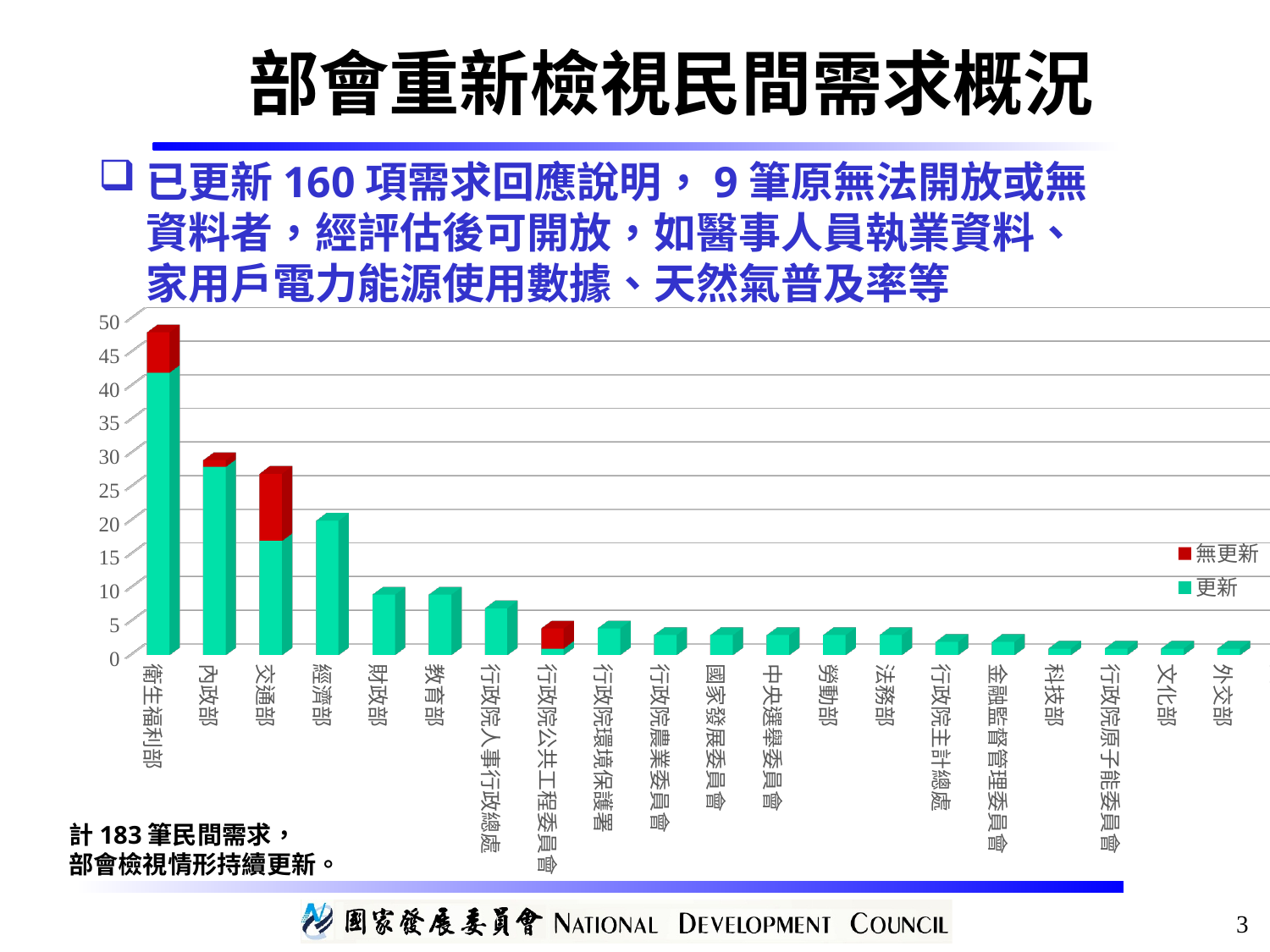
Do the total bar values generally rise or fall from left to right along the x axis? fall Which has the larger total bar, 經濟部 or 財政部? 經濟部 Is the total value for 內政部 greater or less than 25? greater Which has the larger total bar, 衛生福利部 or 內政部? 衛生福利部 Is the total value for 經濟部 greater or less than 15? greater How many categories (ministries/agencies) are shown on the x axis? 20 Is the total value for 財政部 greater or less than 15? less What kind of chart is shown on the slide? bar chart Which category has the highest total bar? 衛生福利部 How many series does the legend list? 2 Which colour represents the 無更新 series in the legend? red